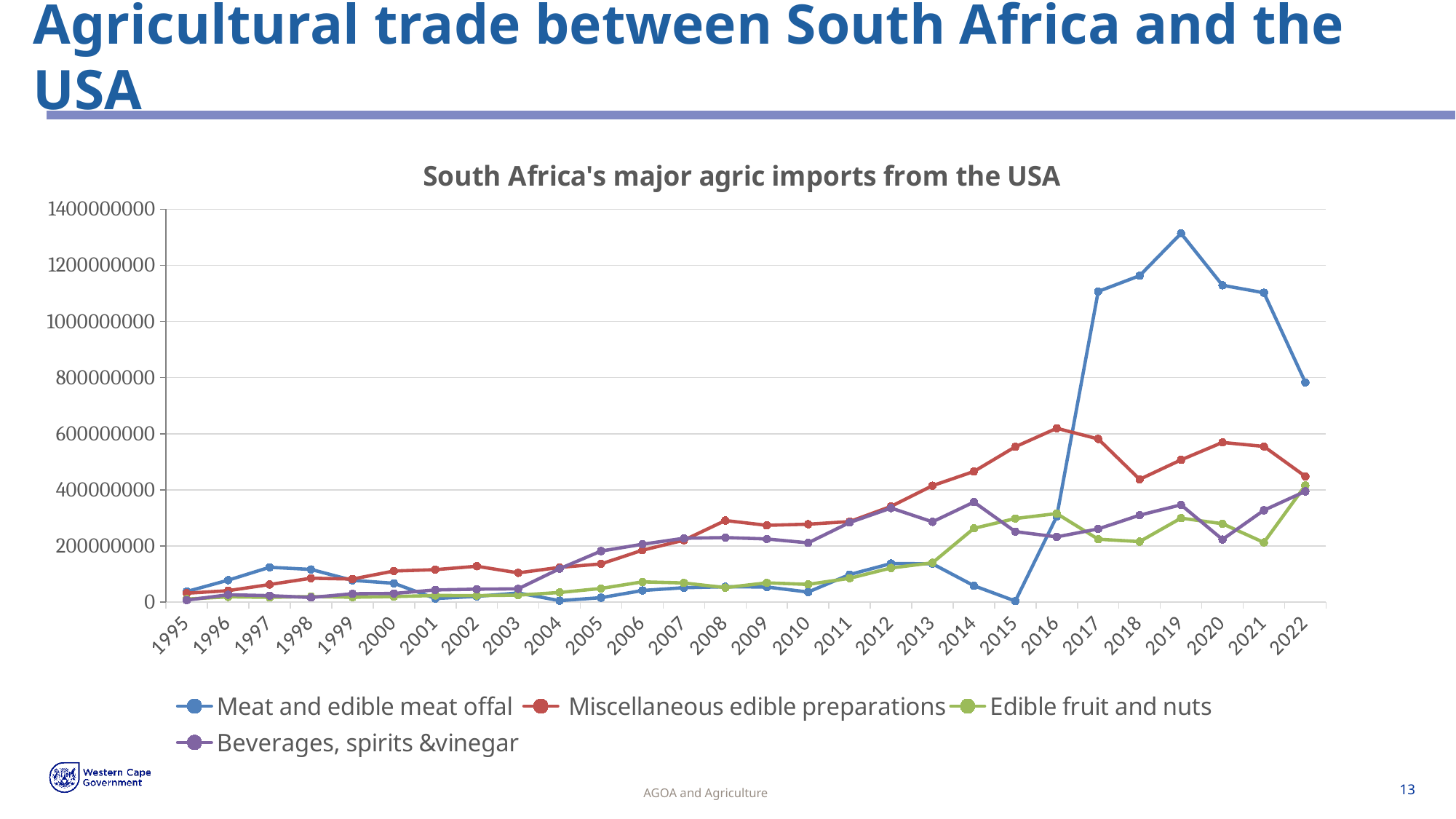
What kind of chart is shown on the slide? Line chart What is the title of the chart? South Africa's major agric imports from the USA Which series has the highest value in 2019? Meat and edible meat offal Is the value for Meat and edible meat offal in 2015 greater or less than 200000000? less Is the value for Meat and edible meat offal in 2019 greater or less than 1200000000? greater Which series has the highest value in 2016? Miscellaneous edible preparations In 2022, which is larger: Meat and edible meat offal or Miscellaneous edible preparations? Meat and edible meat offal Is the value for Beverages, spirits &vinegar in 2022 greater or less than 200000000? greater How many series does the legend list? 4 In which year does Meat and edible meat offal reach its peak? 2019 Does the value for Meat and edible meat offal rise or fall from 2019 to 2022? Fall How many years are plotted along the x axis? 28